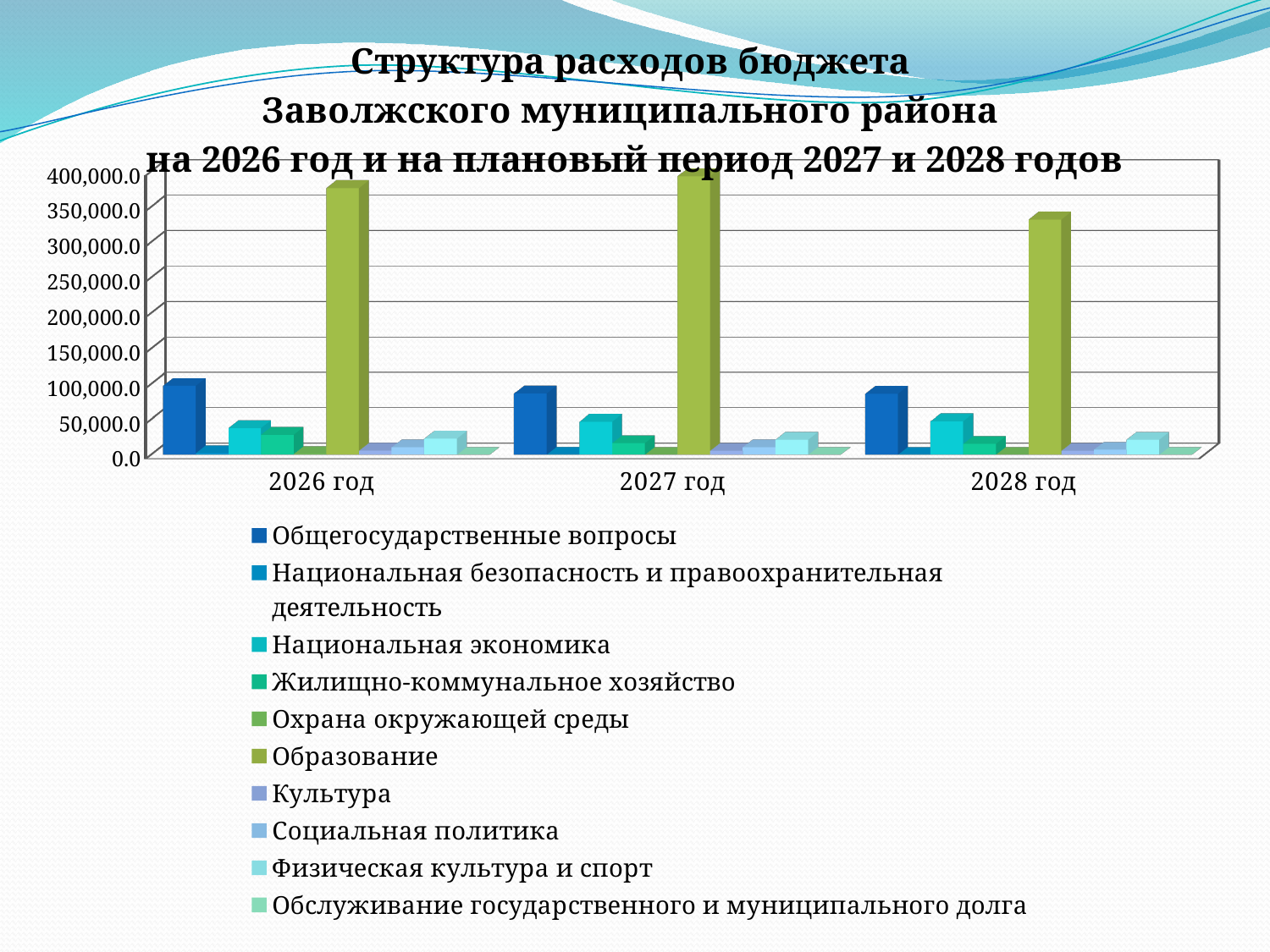
Is the value for Образование in 2026 год greater or less than 350,000.0? greater How many series does the legend list? 10 In which year is the bar for Образование the lowest? 2028 год Which expenditure series has the highest bar in every year? Образование What kind of chart is shown on the slide? Bar chart What is the first line of the chart title? Структура расходов бюджета Is the value for Образование in 2028 год greater or less than 300,000.0? greater Which is larger: Образование in 2027 год or Образование in 2028 год? 2027 год Is the value for Общегосударственные вопросы in 2027 год greater or less than 100,000.0? less In which year is the bar for Образование the highest? 2027 год How many year categories are shown on the x axis? 3